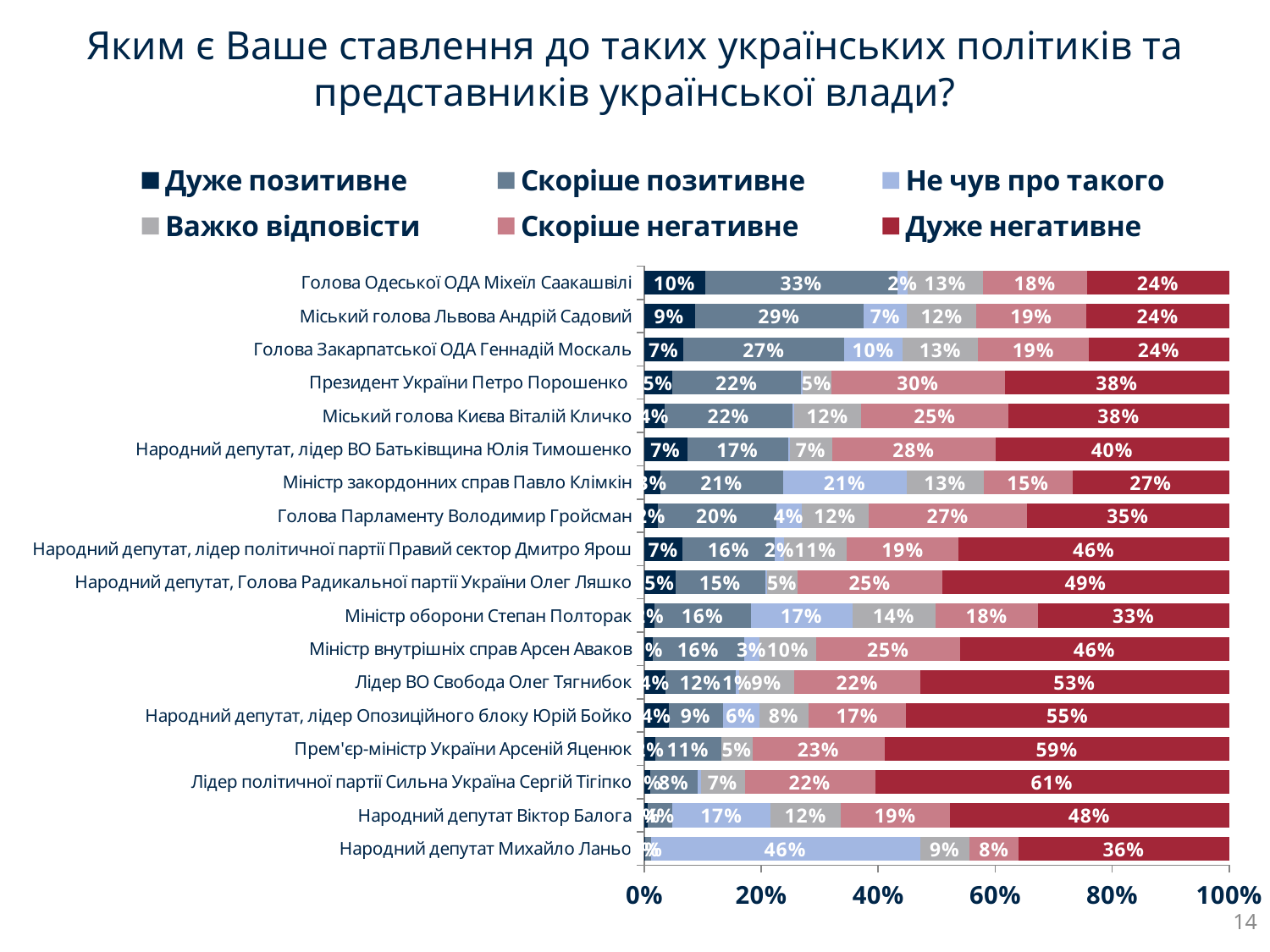
What is the "Скоріше негативне" value for Президент України Петро Порошенко? 30% How many series does the legend list? 6 Which series in the legend is shown in dark red? Дуже негативне Which has the larger "Дуже негативне" value: Прем'єр-міністр України Арсеній Яценюк or Народний депутат, лідер Опозиційного блоку Юрій Бойко? Прем'єр-міністр України Арсеній Яценюк What is the "Не чув про такого" value for Народний депутат Михайло Ланьо? 46% What kind of chart is shown on the slide? Stacked bar chart What is the "Скоріше позитивне" value for Голова Одеської ОДА Міхеїл Саакашвілі? 33% How many politicians (categories) are listed on the chart? 18 What is the "Дуже негативне" value for Лідер політичної партії Сильна Україна Сергій Тігіпко? 61% Which politician has the highest "Дуже позитивне" value? Голова Одеської ОДА Міхеїл Саакашвілі What is the difference between the "Дуже негативне" values for Сергій Тігіпко and Міхеїл Саакашвілі? 37 percentage points Which politician has the highest "Дуже негативне" value? Лідер політичної партії Сильна Україна Сергій Тігіпко